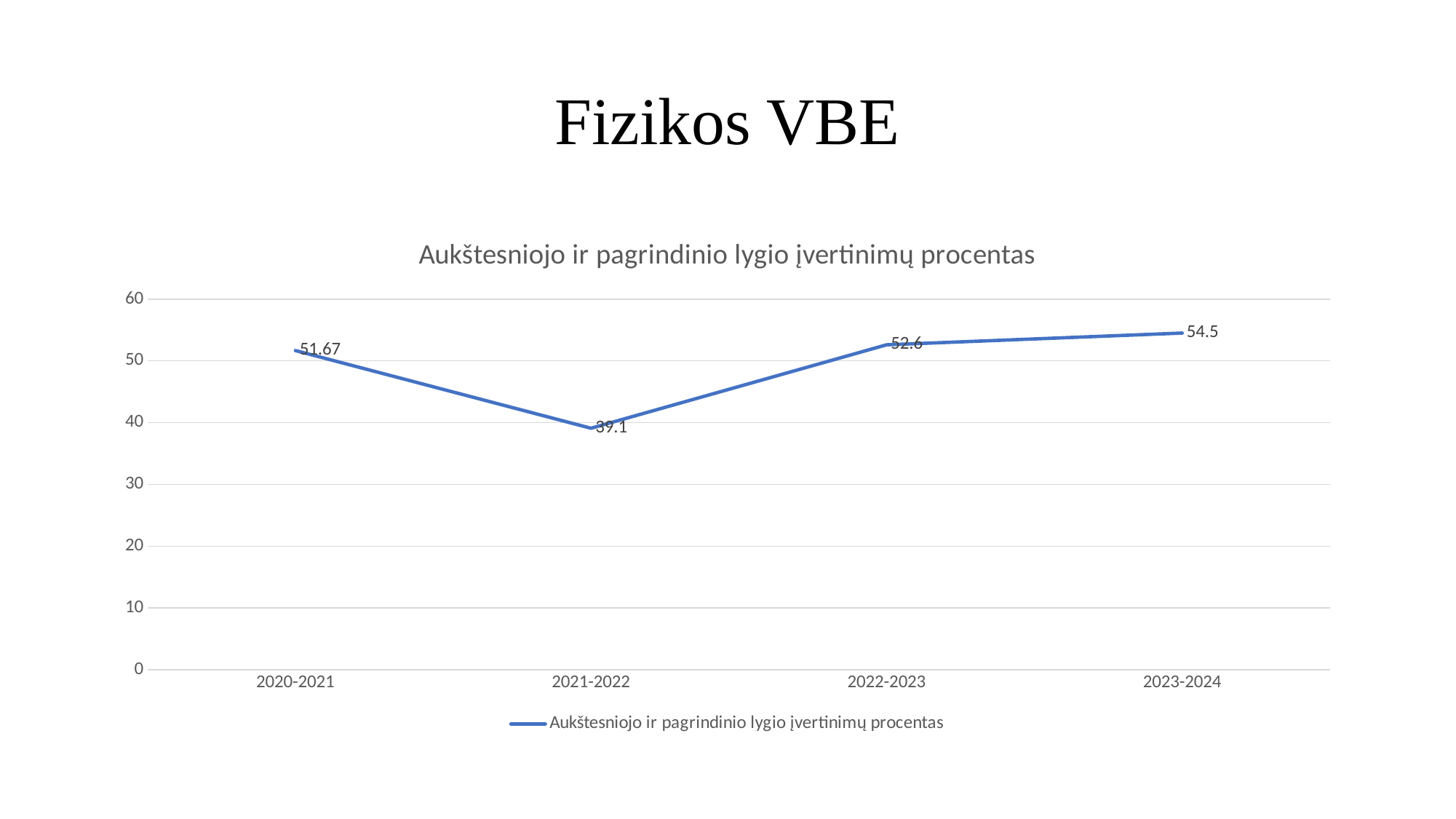
Which period has the highest value? 2023-2024 Is the value for 2021-2022 greater or less than 40? less What kind of chart is shown on the slide? line chart What is the value for 2022-2023? 52.6 Which period has the lowest value? 2021-2022 What is the title of the chart? Aukštesniojo ir pagrindinio lygio įvertinimų procentas What is the value for 2020-2021? 51.67 Which is larger, the value for 2020-2021 or the value for 2022-2023? 2022-2023 What is the difference between the values for 2023-2024 and 2021-2022? 15.4 How many periods are plotted on the x axis? 4 What is the value for 2021-2022? 39.1 What is the value for 2023-2024? 54.5